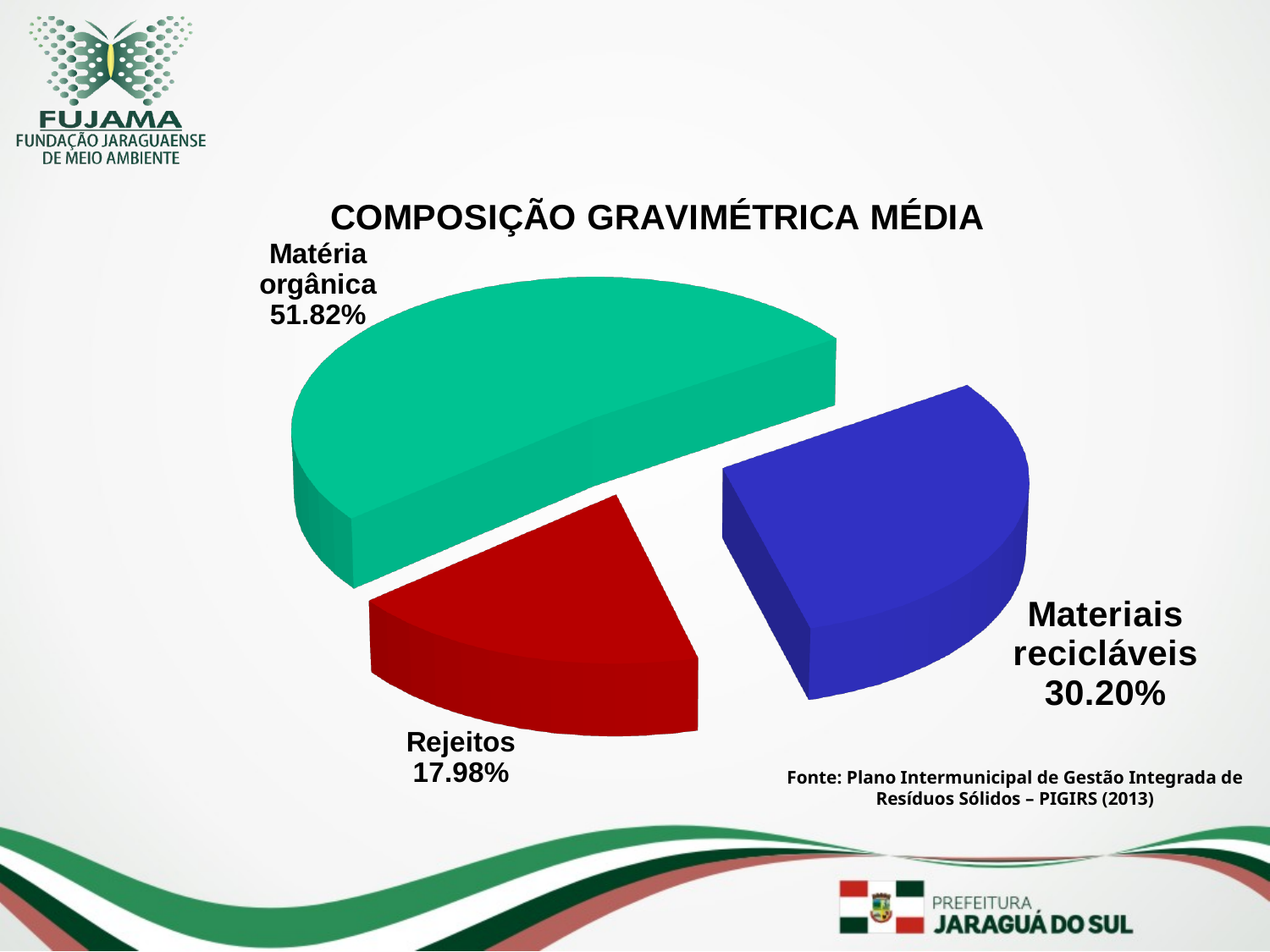
What is the title of the chart? COMPOSIÇÃO GRAVIMÉTRICA MÉDIA What type of chart is shown on the slide? Pie chart What is the difference in percentage points between Materiais recicláveis and Rejeitos? 12.22 What colour is the Rejeitos slice? Red What percentage does the Matéria orgânica slice represent? 51.82% How many slices does the pie chart have? 3 Which is larger, the share for Rejeitos or the share for Materiais recicláveis? Materiais recicláveis Which category has the smallest share of the pie? Rejeitos Which category has the largest share of the pie? Matéria orgânica What percentage does the Materiais recicláveis slice represent? 30.20% What percentage does the Rejeitos slice represent? 17.98% What is the difference in percentage points between Matéria orgânica and Materiais recicláveis? 21.62